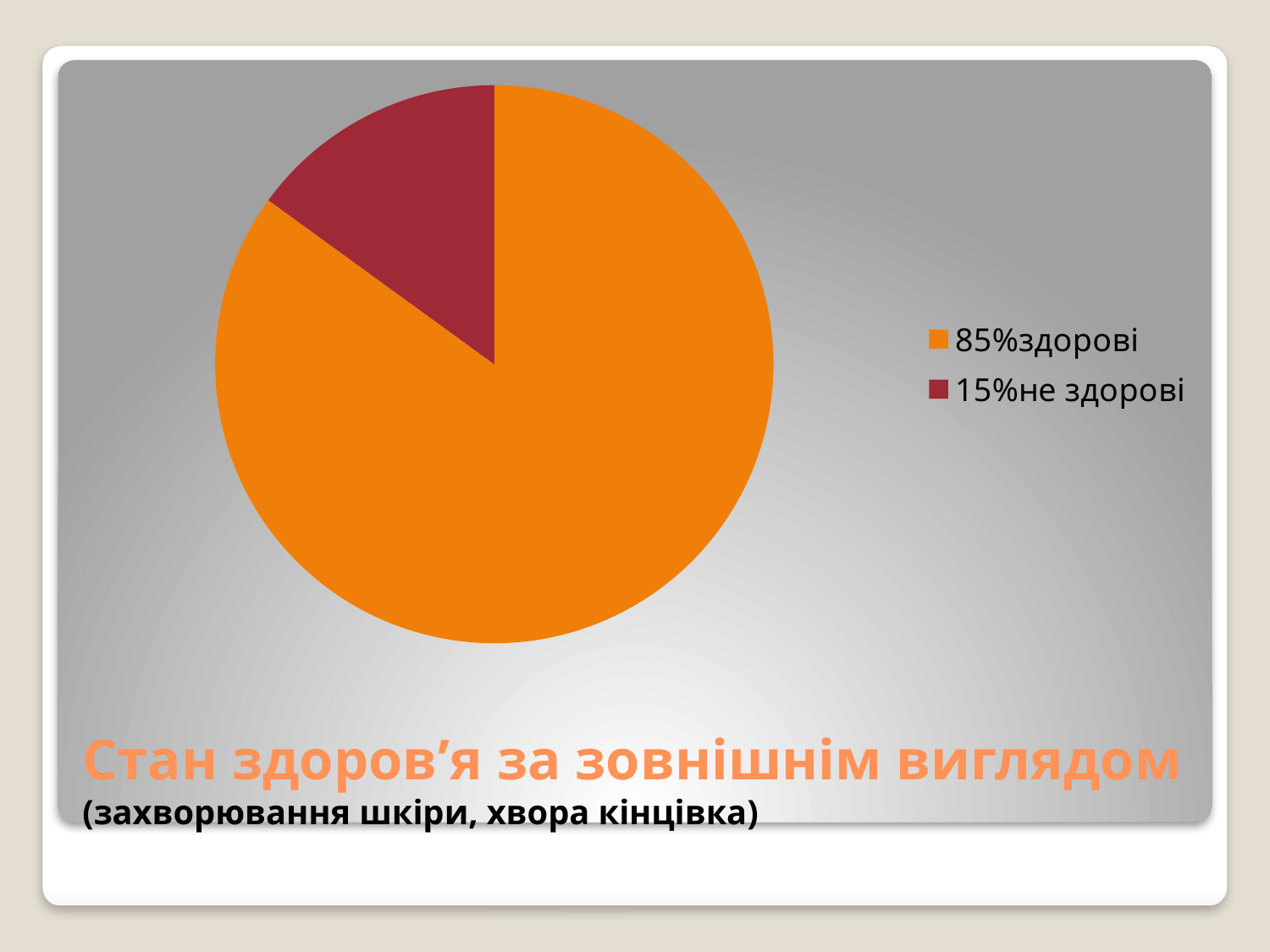
Which slice of the pie chart is the largest? 85%здорові What share of the pie does the 'не здорові' slice represent? 15% What is the title of the chart on the slide? Стан здоров’я за зовнішнім виглядом What is the difference in percentage points between the 'здорові' and 'не здорові' slices? 70 What share of the pie does the 'здорові' slice represent? 85% How many slices does the pie chart have? 2 How many entries does the legend of the pie chart list? 2 Which is larger, the 'здорові' slice or the 'не здорові' slice? здорові Which slice of the pie chart is the smallest? 15%не здорові What colour is the 'не здорові' slice in the pie chart? dark red What kind of chart is shown on the slide? pie chart